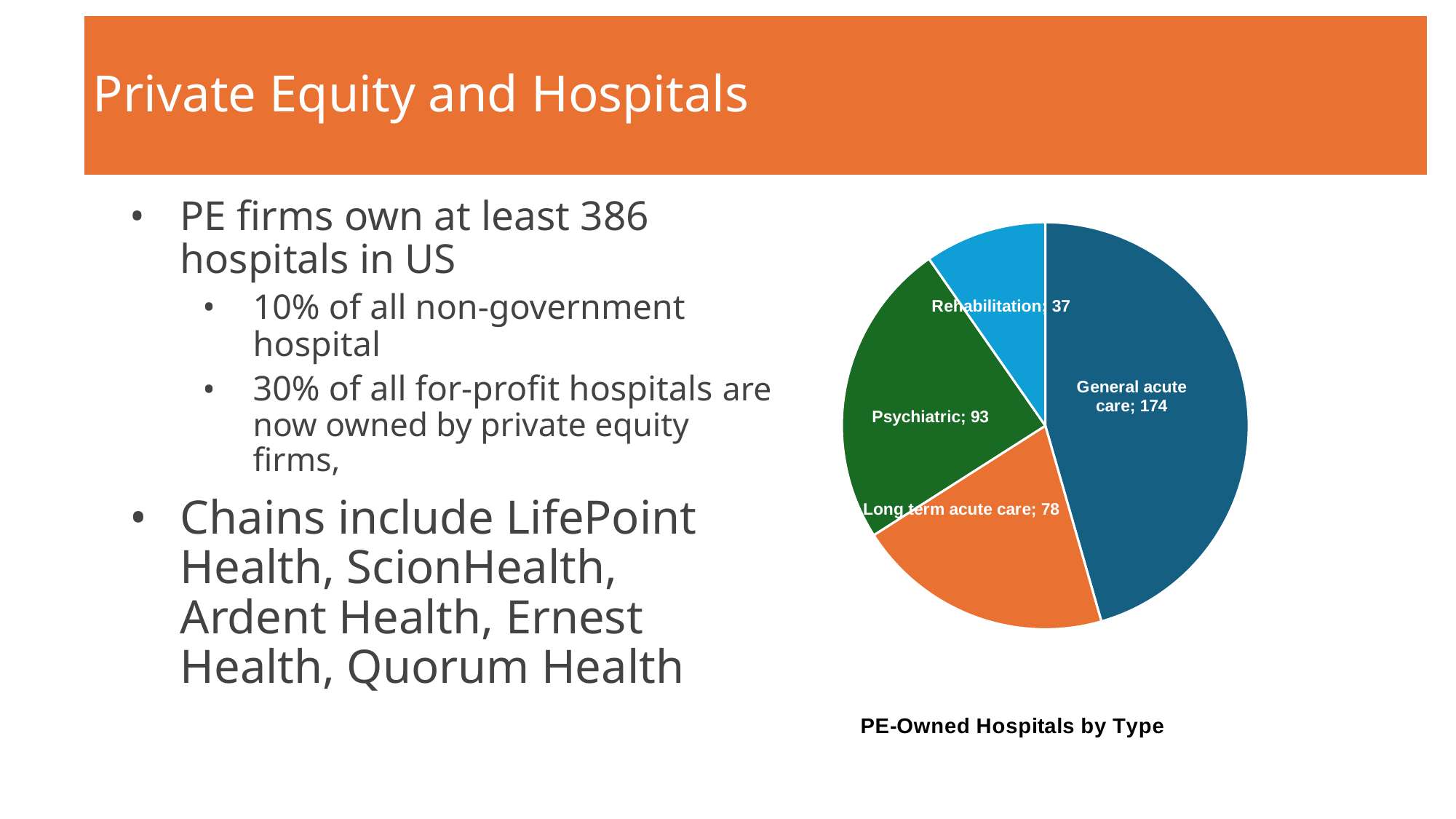
Which hospital type has the largest slice? General acute care What is the difference between the General acute care and Psychiatric values? 81 How many hospital types (slices) does the pie chart show? 4 What is the value for General acute care? 174 What is the value for Psychiatric? 93 What is the total of all four slices in the pie chart? 382 What is the title of the chart? PE-Owned Hospitals by Type What is the value for Rehabilitation? 37 What is the value for Long term acute care? 78 Which is larger, Psychiatric or Long term acute care? Psychiatric What type of chart is shown on the slide? Pie chart Which hospital type has the smallest slice? Rehabilitation